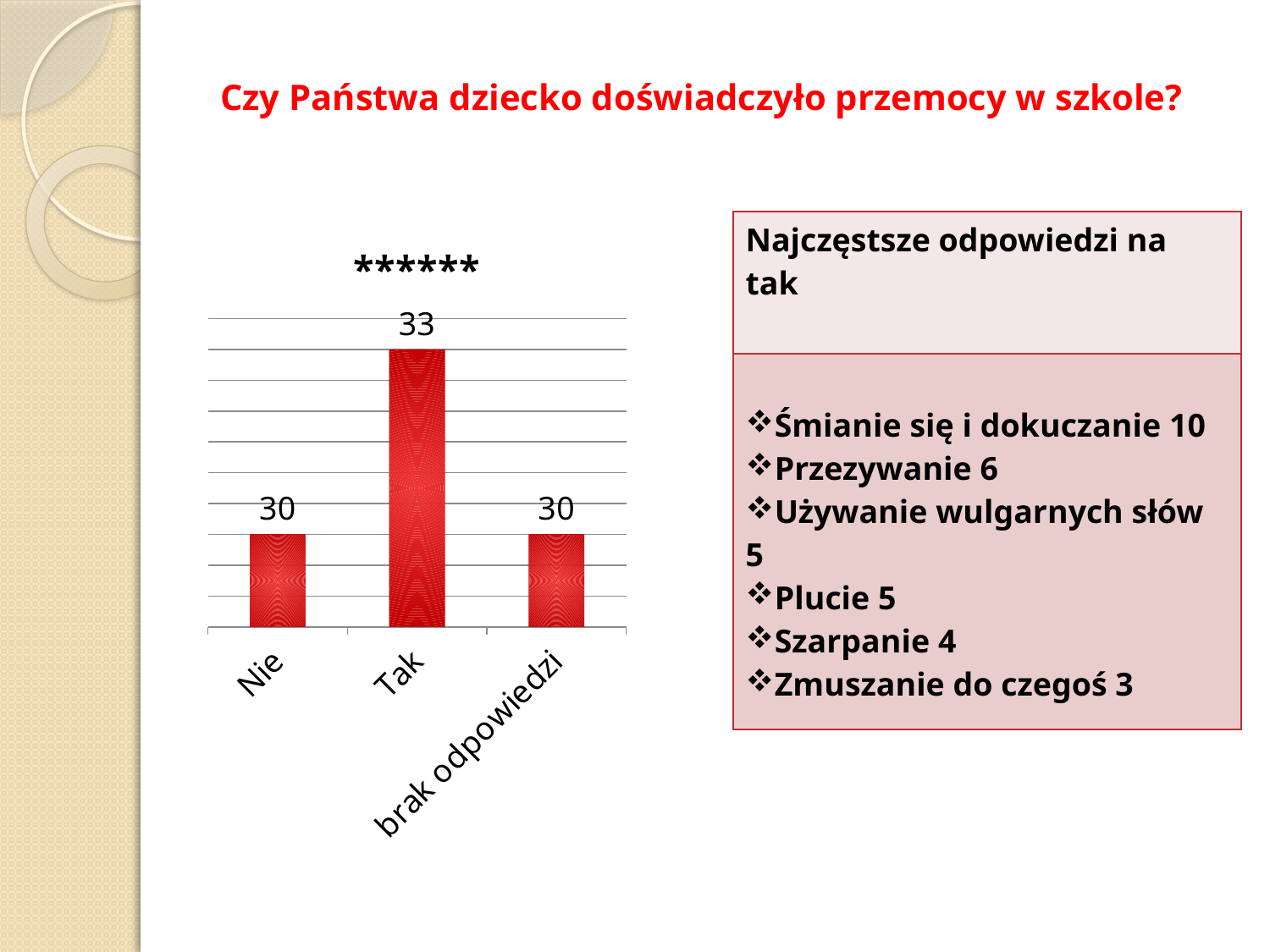
What is the difference between the values for Tak and Nie? 3 How many categories are shown on the x axis? 3 What colour are the bars in the chart? red What is the value for brak odpowiedzi? 30 Do the values for Nie and brak odpowiedzi differ? No, both are 30 What is the total of the three plotted values? 93 Which is larger, the value for Tak or the value for brak odpowiedzi? Tak What kind of chart is shown on the slide? bar chart Which category has the highest value? Tak What is the value for Nie? 30 What is the value for Tak? 33 What is the chart's title as printed above the bars? ******